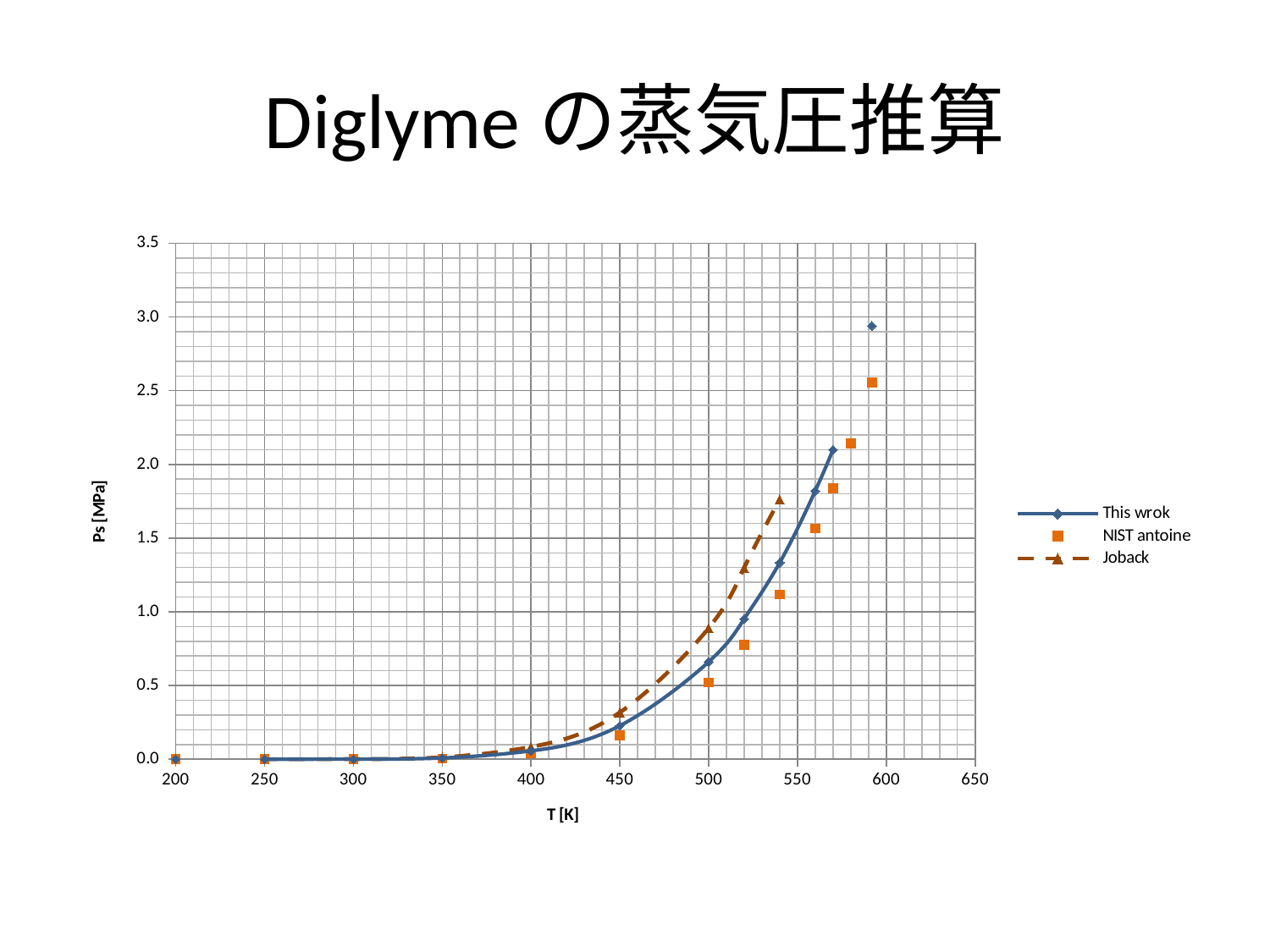
Is the value of the 'This wrok' series at 570 K greater or less than 2.0? greater What kind of chart is shown on the slide? line chart What is the label of the horizontal axis? T [K] How many series does the legend list? 3 Is the value of the 'This wrok' series at 500 K greater or less than 1.0? less Do the values of the 'This wrok' series rise or fall as T increases? rise At about 590 K, which series has the larger value, 'This wrok' or 'NIST antoine'? This wrok Is the value of the 'This wrok' series at about 590 K greater or less than 2.5? greater What is the label of the vertical axis? Ps [MPa] At 540 K, which series has the larger value, 'Joback' or 'This wrok'? Joback